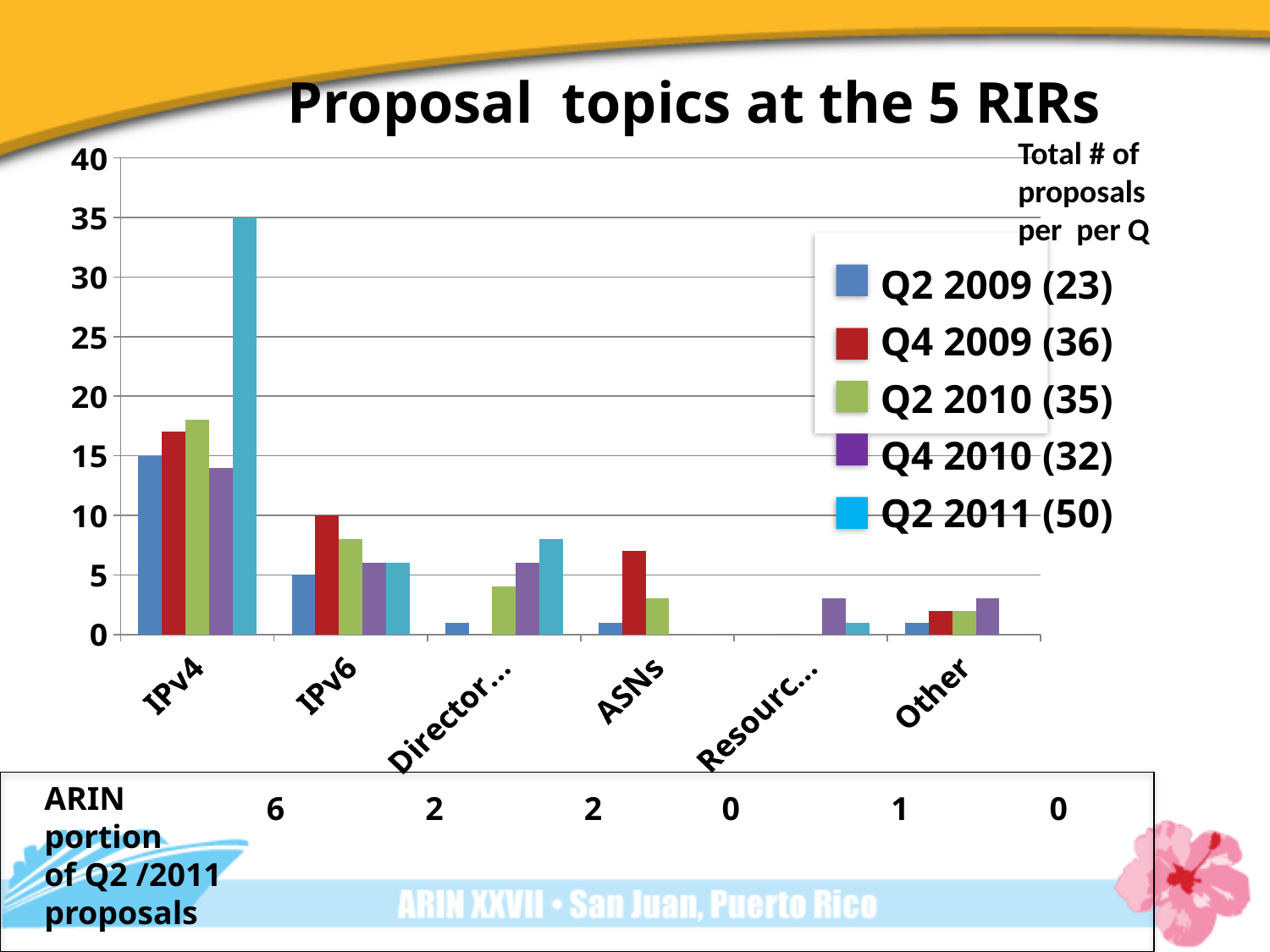
Which category has the tallest bar in the chart? IPv4 What is the value for IPv4 in the Q2 2011 series? 35 What is the value for IPv4 in the Q2 2009 series? 15 Is the value for ASNs in the Q4 2009 series greater or less than 5? greater Which is larger for the Q2 2011 series: IPv4 or IPv6? IPv4 Which series has the highest value for IPv4? Q2 2011 What is the title of the chart? Proposal topics at the 5 RIRs How many series does the legend list? 5 What is the value for IPv6 in the Q4 2009 series? 10 What kind of chart is shown on the slide? bar chart Is the value for Other in the Q4 2010 series greater or less than 5? less How many topic categories are shown on the x axis? 6